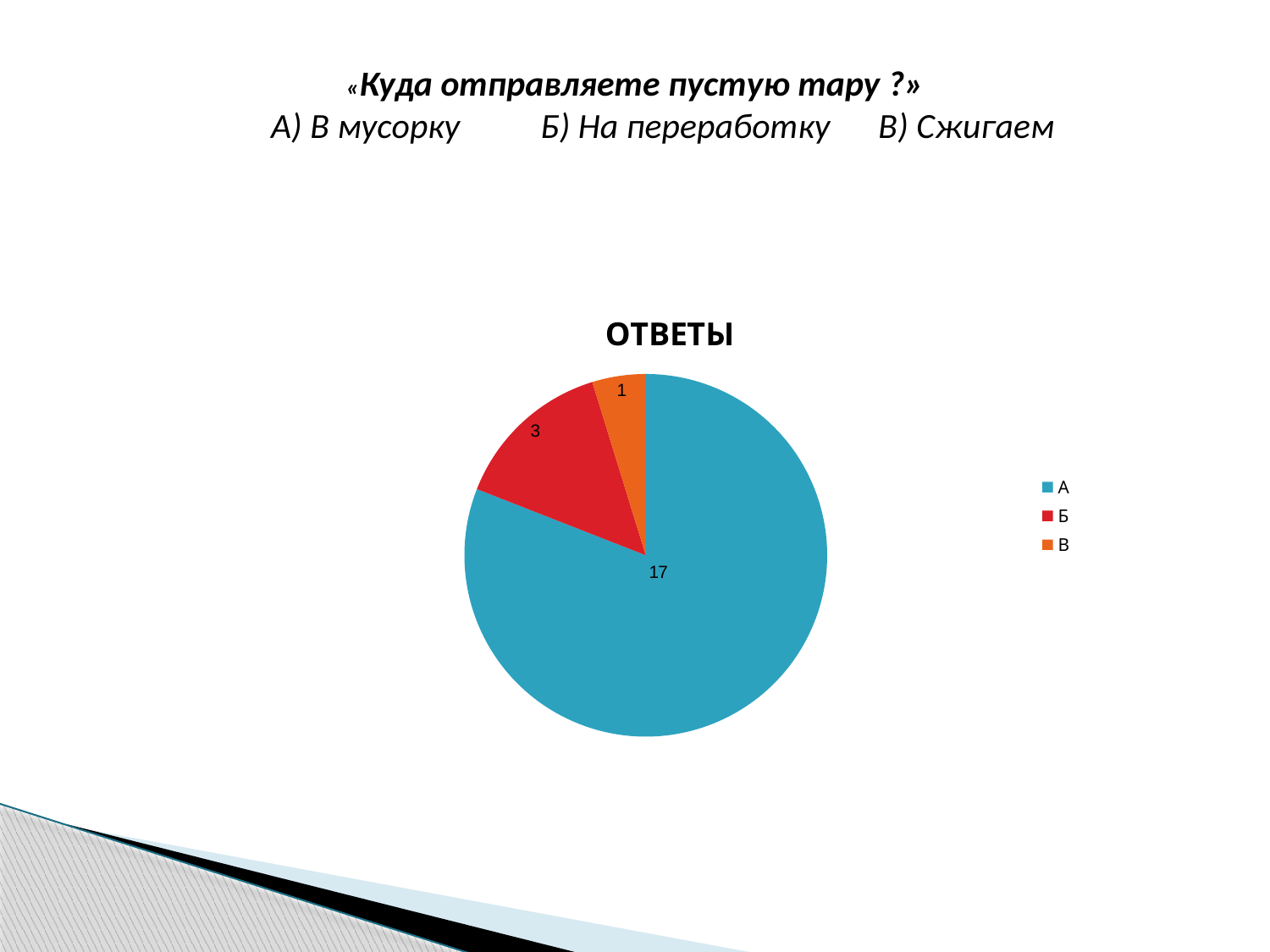
Which colour represents category Б in the legend? red Which category has the smallest slice? В How many categories does the legend list? 3 Which category has the largest slice? А What is the difference between the values for А and Б? 14 What is the title of the chart? ОТВЕТЫ What is the value for category Б? 3 What is the total of all slices in the pie? 21 Which is larger, the value for Б or the value for В? Б What kind of chart is shown on the slide? pie chart What is the value for category А? 17 What is the value for category В? 1